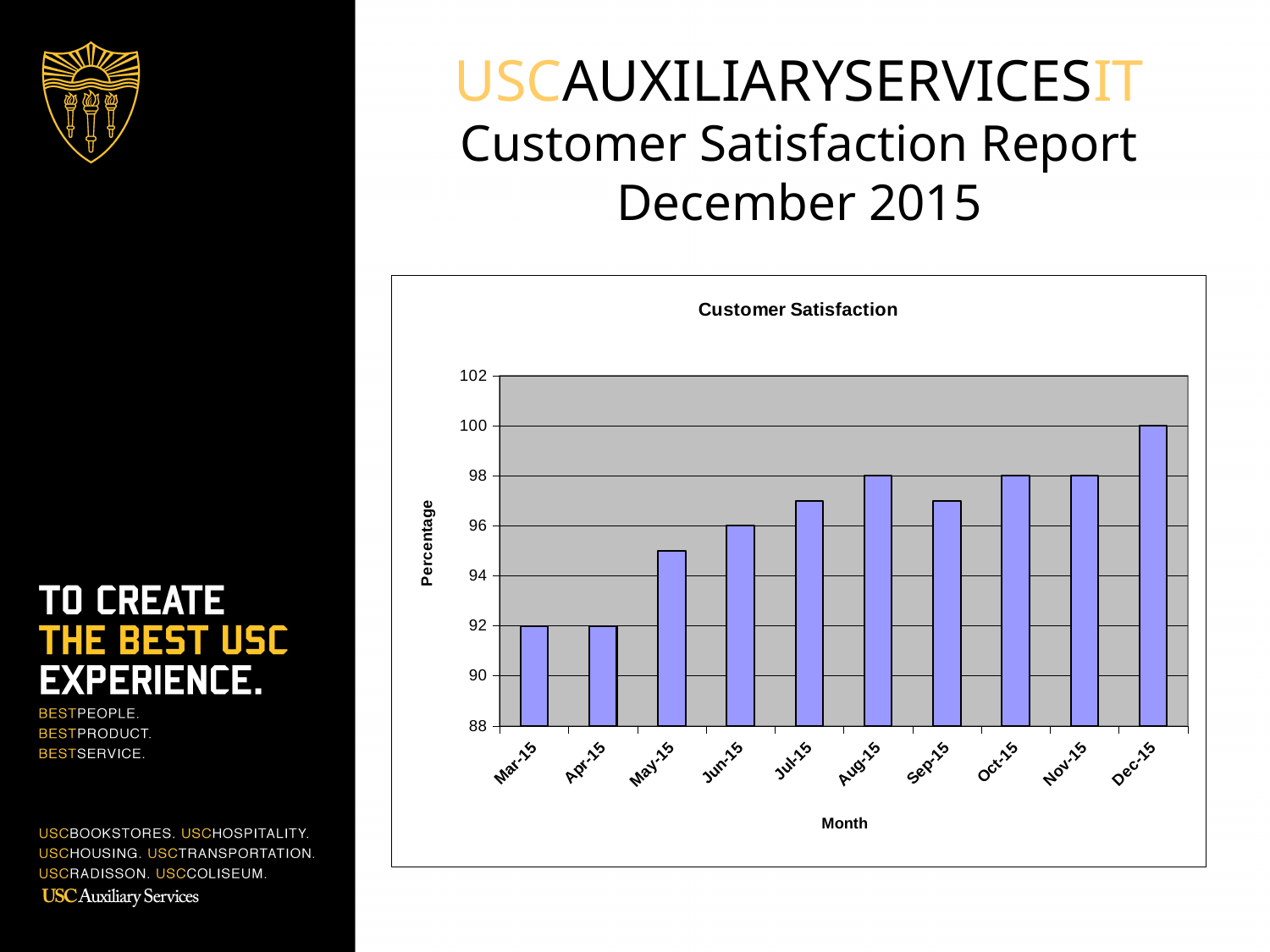
Which month has the highest customer satisfaction percentage? Dec-15 Do the customer satisfaction values generally rise or fall from Mar-15 to Dec-15? Rise Is the value for May-15 greater or less than 94? greater What is the customer satisfaction percentage for Oct-15? 98 What is the customer satisfaction percentage for Dec-15? 100 What is the difference between the customer satisfaction percentage for Dec-15 and Mar-15? 8 What is the customer satisfaction percentage for Jun-15? 96 What type of chart is shown on the slide? Bar chart How many months are plotted on the x axis of the chart? 10 Is the value for Sep-15 greater or less than 98? less What is the customer satisfaction percentage for Mar-15? 92 What is the title of the chart? Customer Satisfaction